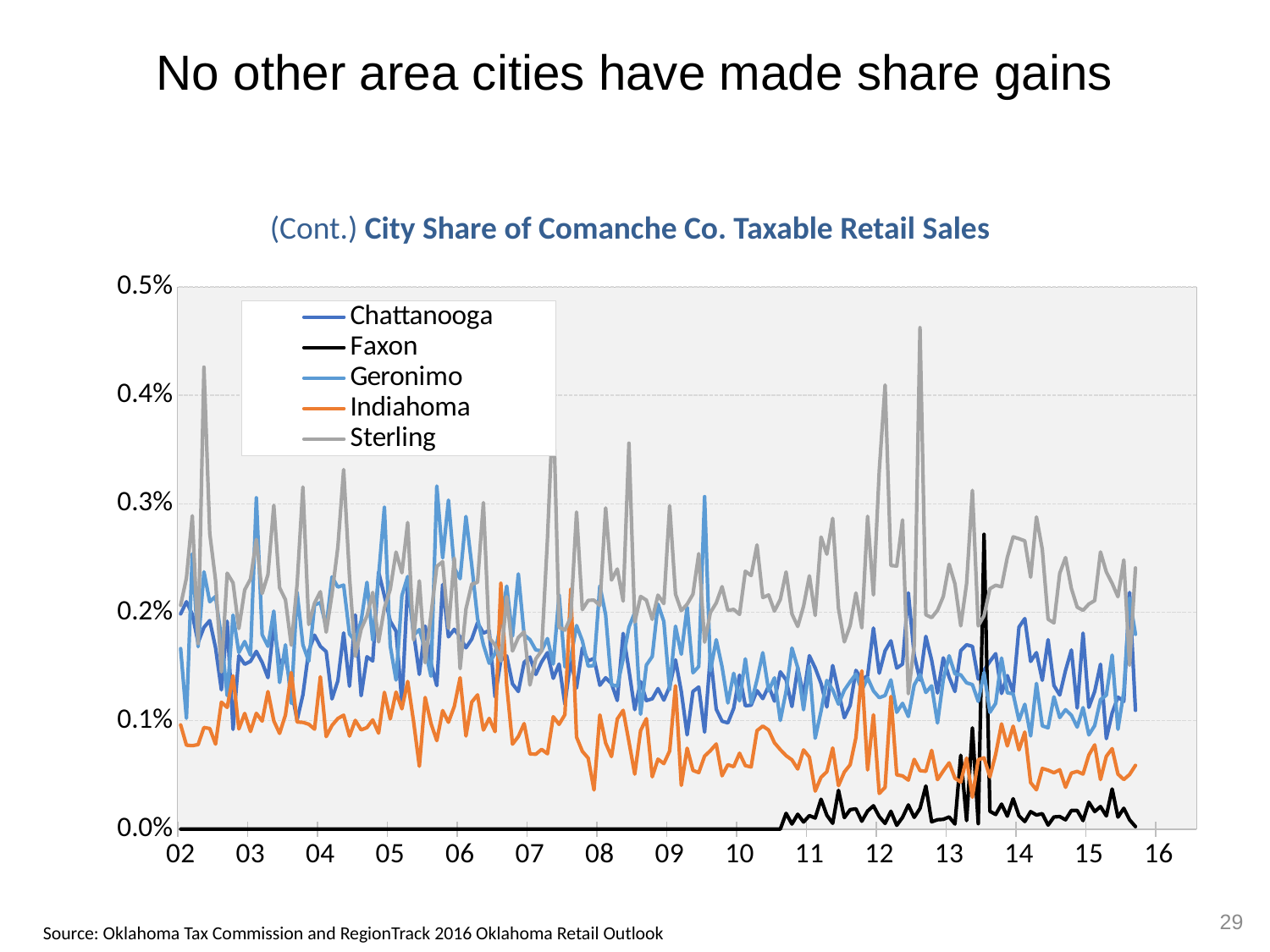
Which city generally has the lowest share across the chart? Faxon Is the highest peak for Sterling around 2012-13 greater or less than 0.4%? greater Is the value for Faxon in 2005 greater or less than 0.1%? less How many series does the legend list? 5 Which cities are listed in the chart legend? Chattanooga, Faxon, Geronimo, Indiahoma, Sterling Does the Indiahoma share generally rise or fall from 2002 to 2015? fall Which city's line is drawn in black? Faxon What kind of chart is shown on the slide? line chart Around 2005, which is larger: the share for Sterling or the share for Indiahoma? Sterling Which city generally has the highest share across the chart? Sterling Does the Geronimo share generally rise or fall from 2002 to 2015? fall Is the value for Indiahoma at the end of 2015 greater or less than 0.1%? less